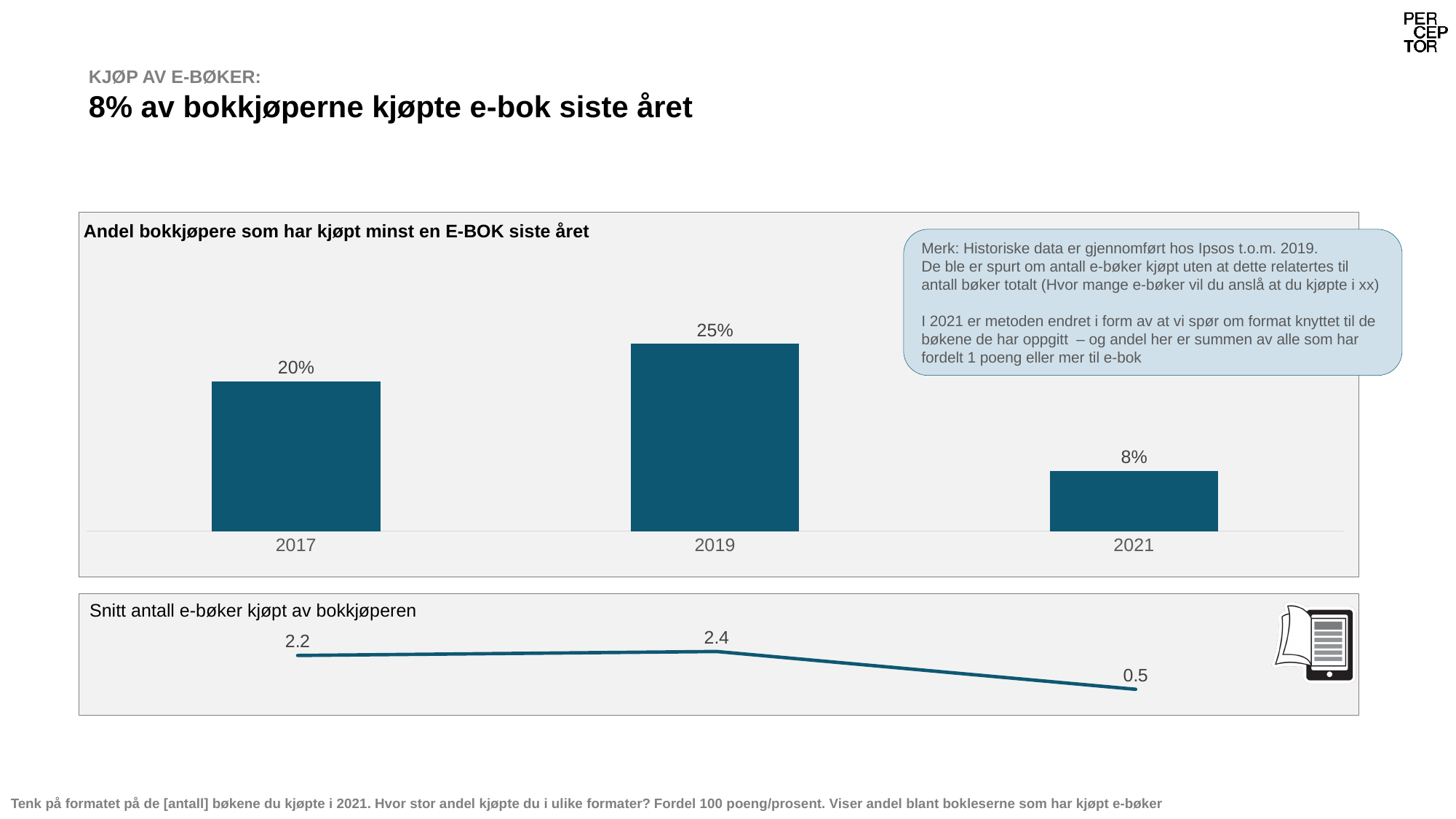
In the chart 'Andel bokkjøpere som har kjøpt minst en E-BOK siste året', what is the value for 2021? 8% In the chart 'Snitt antall e-bøker kjøpt av bokkjøperen', what is the value for 2021? 0.5 In the chart 'Andel bokkjøpere som har kjøpt minst en E-BOK siste året', what is the difference between the 2019 and 2017 values? 5% In the chart 'Andel bokkjøpere som har kjøpt minst en E-BOK siste året', what is the value for 2019? 25% What kind of chart is 'Snitt antall e-bøker kjøpt av bokkjøperen'? Line chart What kind of chart is 'Andel bokkjøpere som har kjøpt minst en E-BOK siste året'? Bar chart In the chart 'Snitt antall e-bøker kjøpt av bokkjøperen', which year has the highest value? 2019 In the chart 'Snitt antall e-bøker kjøpt av bokkjøperen', what is the difference between the 2019 and 2021 values? 1.9 In the chart 'Andel bokkjøpere som har kjøpt minst en E-BOK siste året', which year has the lowest value? 2021 In the chart 'Snitt antall e-bøker kjøpt av bokkjøperen', what is the value for 2017? 2.2 In the chart 'Andel bokkjøpere som har kjøpt minst en E-BOK siste året', which year has the highest value? 2019 In the chart 'Andel bokkjøpere som har kjøpt minst en E-BOK siste året', how many years are shown? 3